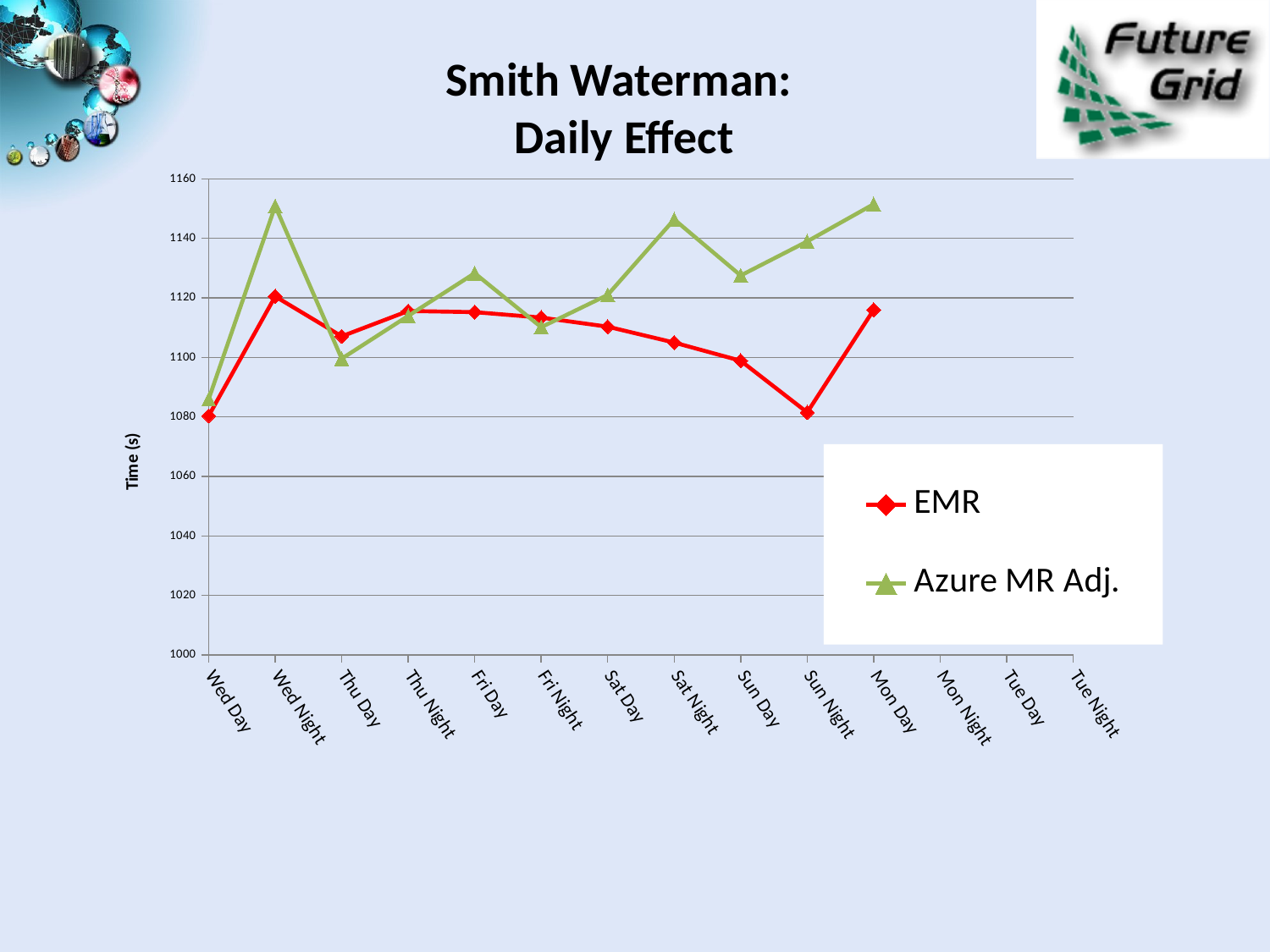
What is the label of the vertical axis? Time (s) Is the Azure MR Adj. value for Fri Day greater or less than 1120? greater How many data points are plotted for the EMR series? 11 What are the two series named in the legend? EMR and Azure MR Adj. Does the EMR series rise or fall from Thu Night to Sun Night? fall Is the EMR value for Thu Day greater or less than 1100? greater How many series does the legend list? 2 Is the EMR value for Sun Night greater or less than 1100? less What kind of chart is shown on the slide? line chart At Wed Night, which series has the higher value, EMR or Azure MR Adj.? Azure MR Adj. At Sun Night, which series has the higher value, EMR or Azure MR Adj.? Azure MR Adj.